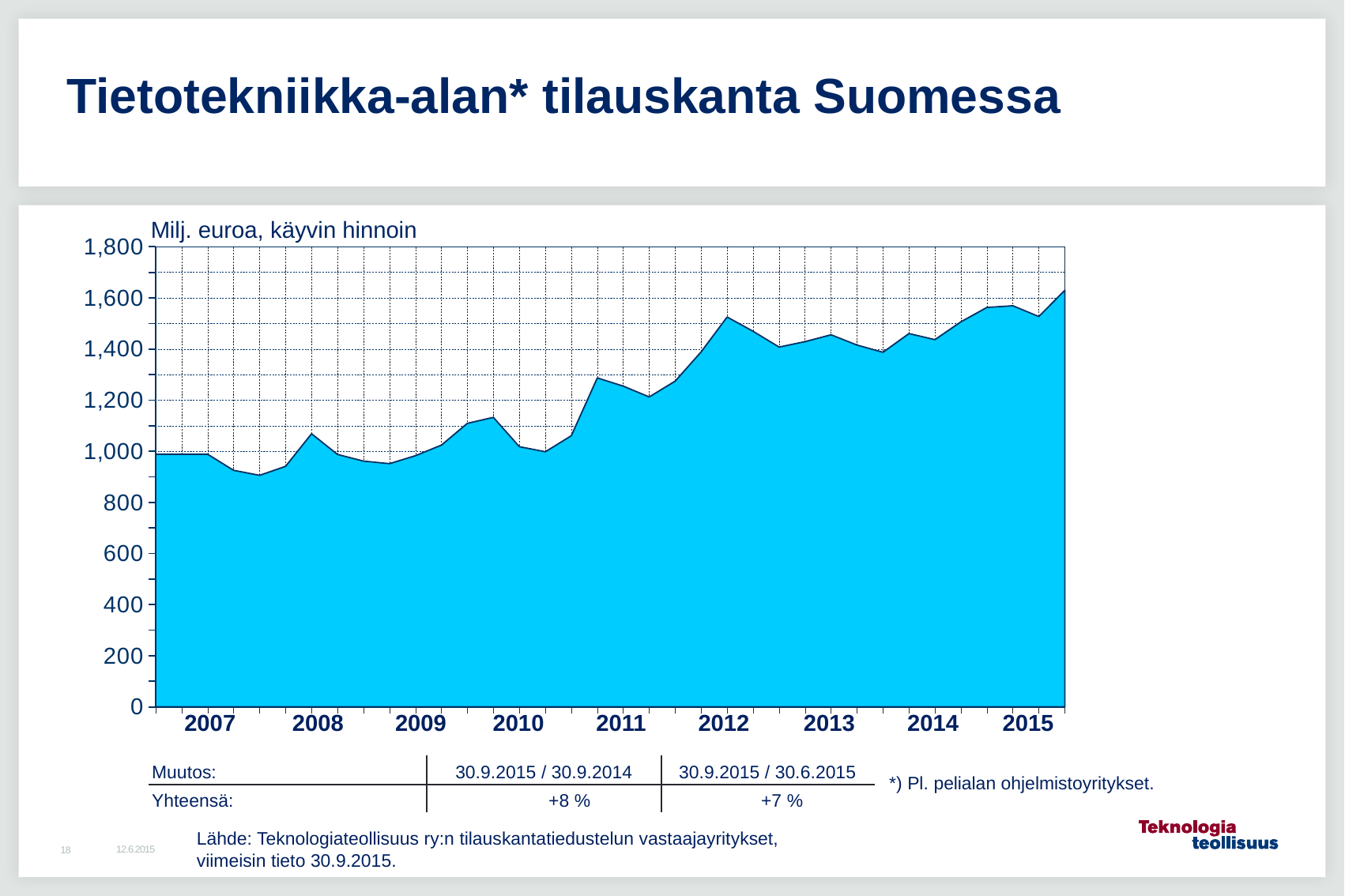
Which is larger, the value at the start of 2012 or the value at the start of 2008? 2012 In which year does the series reach its highest point? 2015 Is the value at the start of 2010 greater or less than 1,200? less How many years are labelled on the x axis? 9 What kind of chart is shown on the slide? Area chart What is the highest value shown on the y axis? 1,800 Is the value at the end of the series in 2015 greater or less than 1,400? greater What is the title of the slide's chart? Tietotekniikka-alan* tilauskanta Suomessa Is the value at the start of 2007 greater or less than 1,200? less According to the table below the chart, what is the change from 30.9.2014 to 30.9.2015? +8 % Overall, do the values rise or fall from 2007 to 2015? Rise What is the unit label shown above the chart's y axis? Milj. euroa, käyvin hinnoin